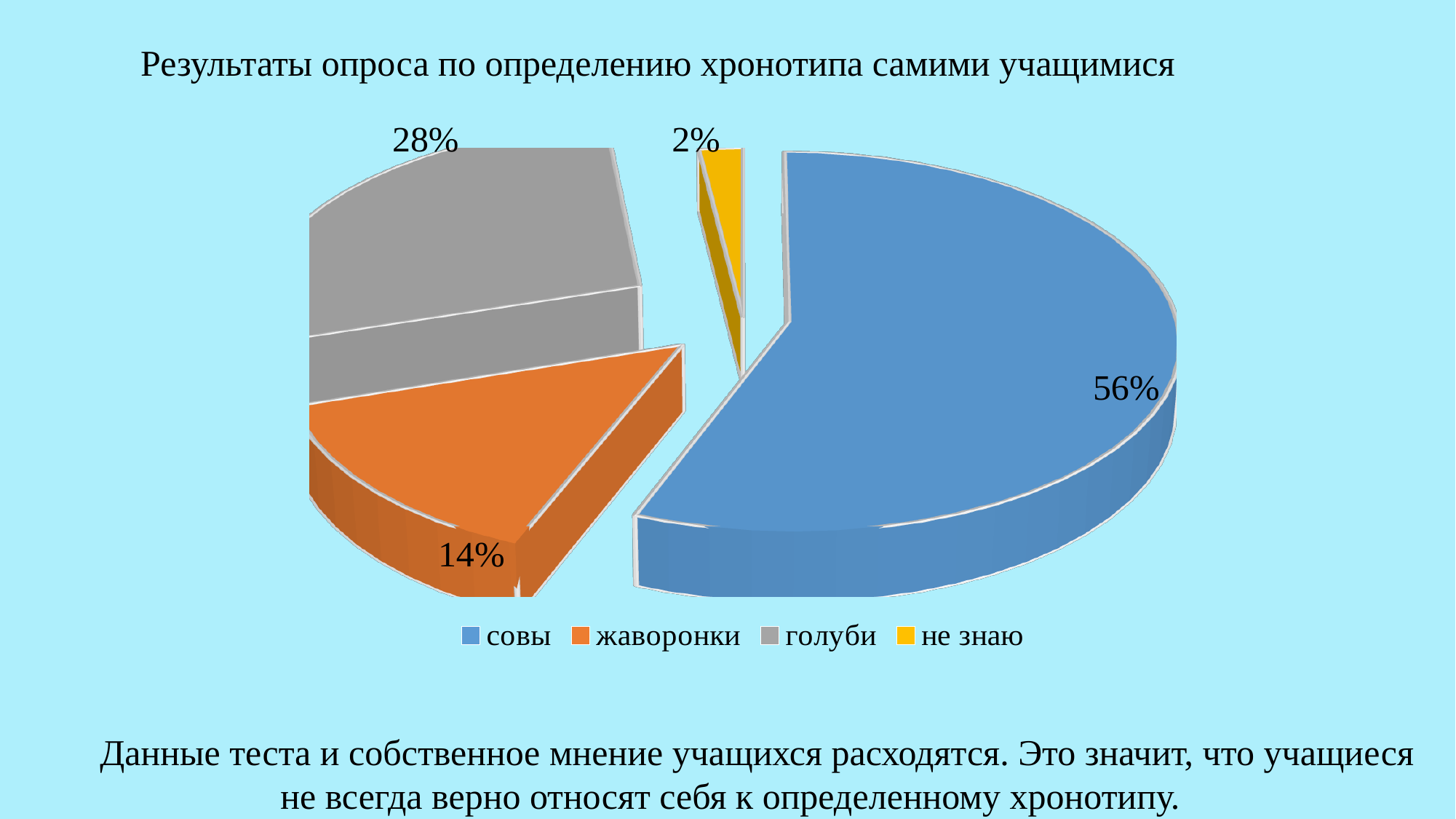
What percentage of the pie is labelled for голуби? 28% What percentage of the pie is labelled for жаворонки? 14% What is the difference in percentage points between совы and голуби? 28 What kind of chart is shown on the slide? pie chart What percentage of the pie is labelled for совы? 56% How many categories does the pie chart show? 4 What is the title of the chart? Результаты опроса по определению хронотипа самими учащимися Which category has the smallest share of the pie? не знаю What colour is the slice for жаворонки? orange Which is larger, the share for голуби or the share for жаворонки? голуби Which category has the largest share of the pie? совы What percentage of the pie is labelled for не знаю? 2%